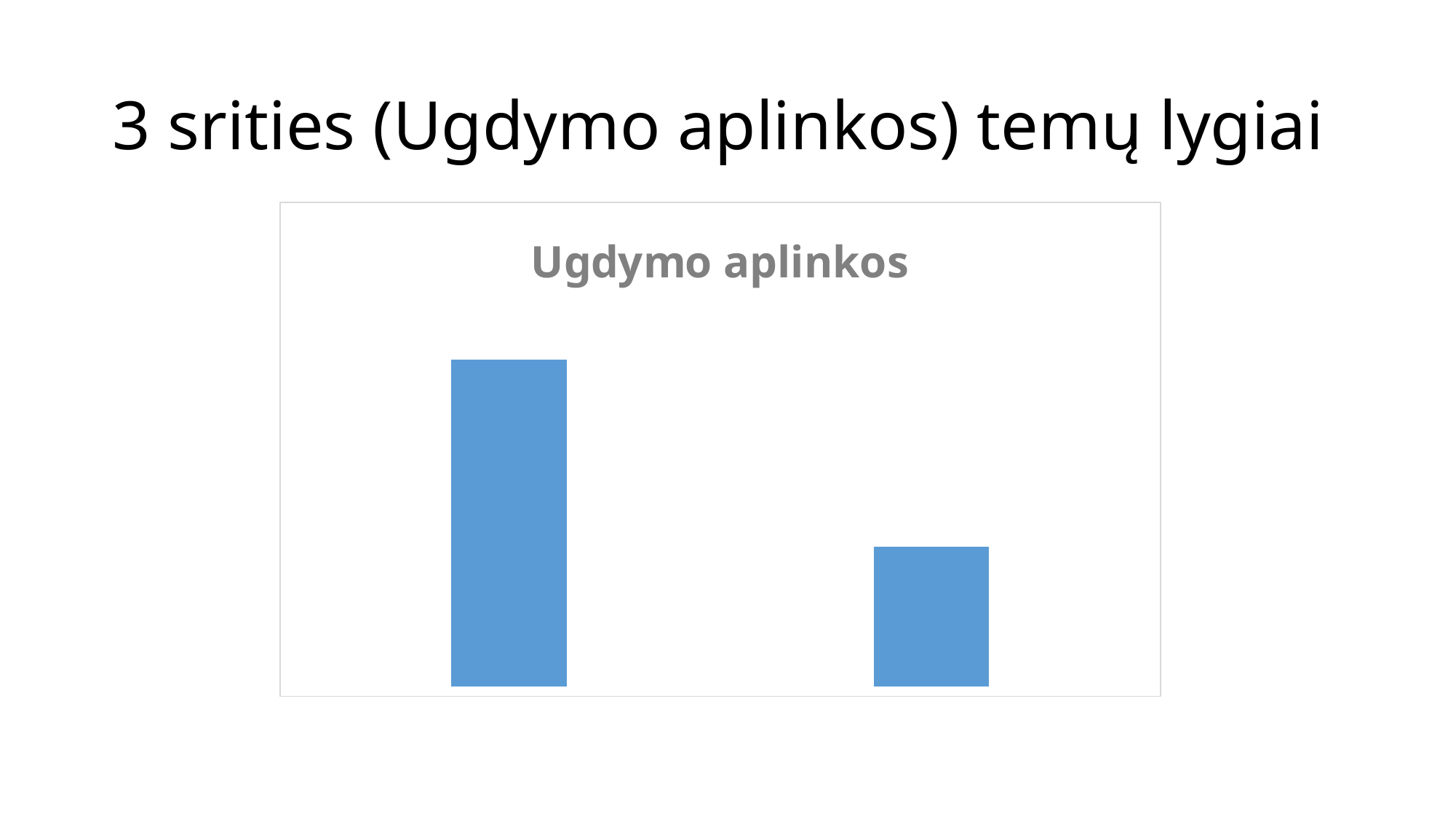
What kind of chart is shown on the slide? bar chart What colour are the bars in the chart? blue Which bar is taller, the left one or the right one? the left one How many bars does the chart show? 2 What is the title of the chart? Ugdymo aplinkos Do the bar values rise or fall from left to right? fall